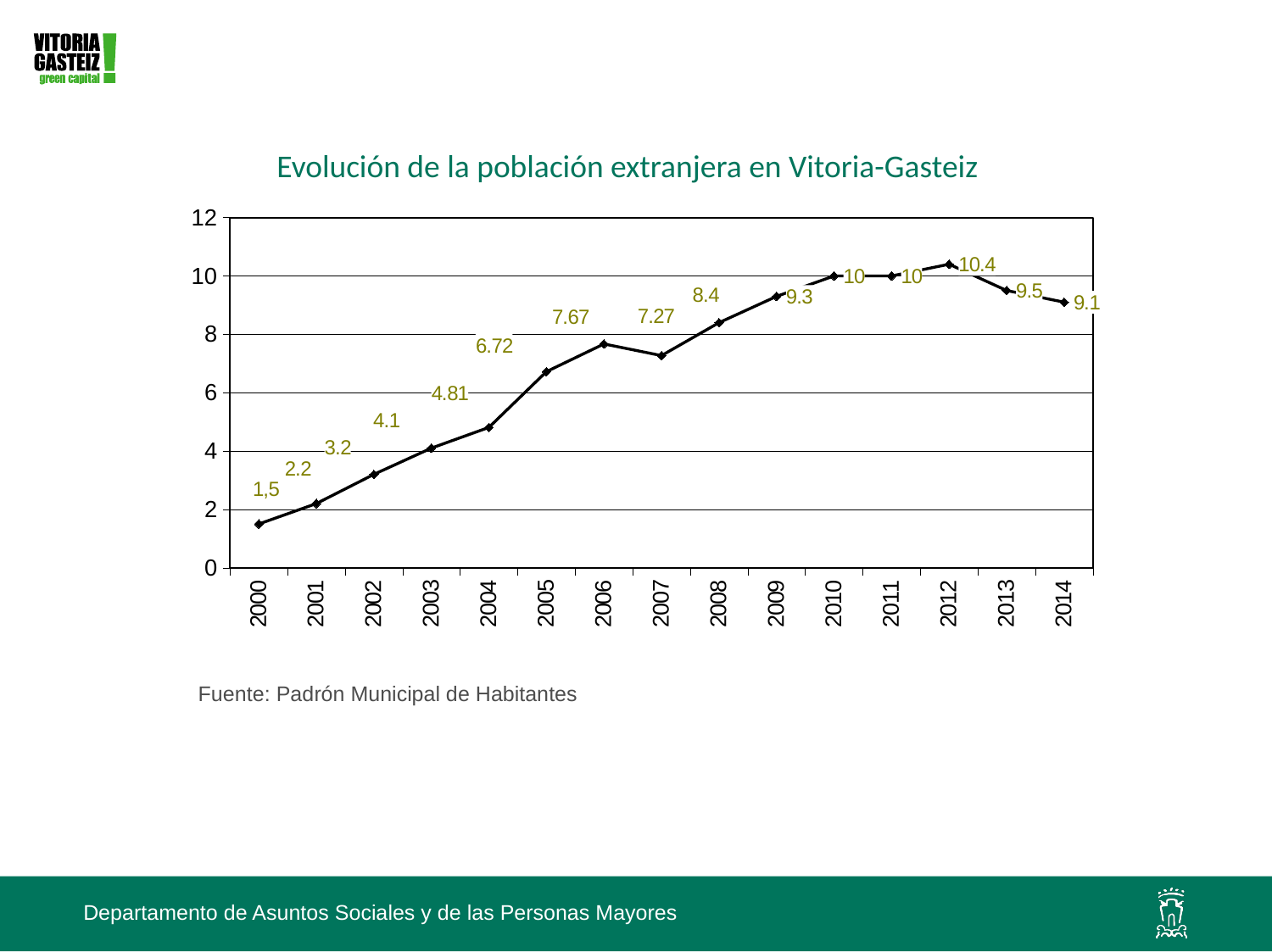
What is the value for 2006? 7.67 What is the difference between the values for 2012 and 2014? 1.3 What is the value for 2000? 1,5 What type of chart is shown on the slide? Line chart What is the title of the chart? Evolución de la población extranjera en Vitoria-Gasteiz How many years are plotted on the x axis? 15 Which year has the lowest value? 2000 Does the value rise or fall from 2012 to 2014? Fall What is the value for 2012? 10.4 Which is larger, the value for 2006 or the value for 2007? 2006 Which year has the highest value? 2012 What is the value for 2014? 9.1